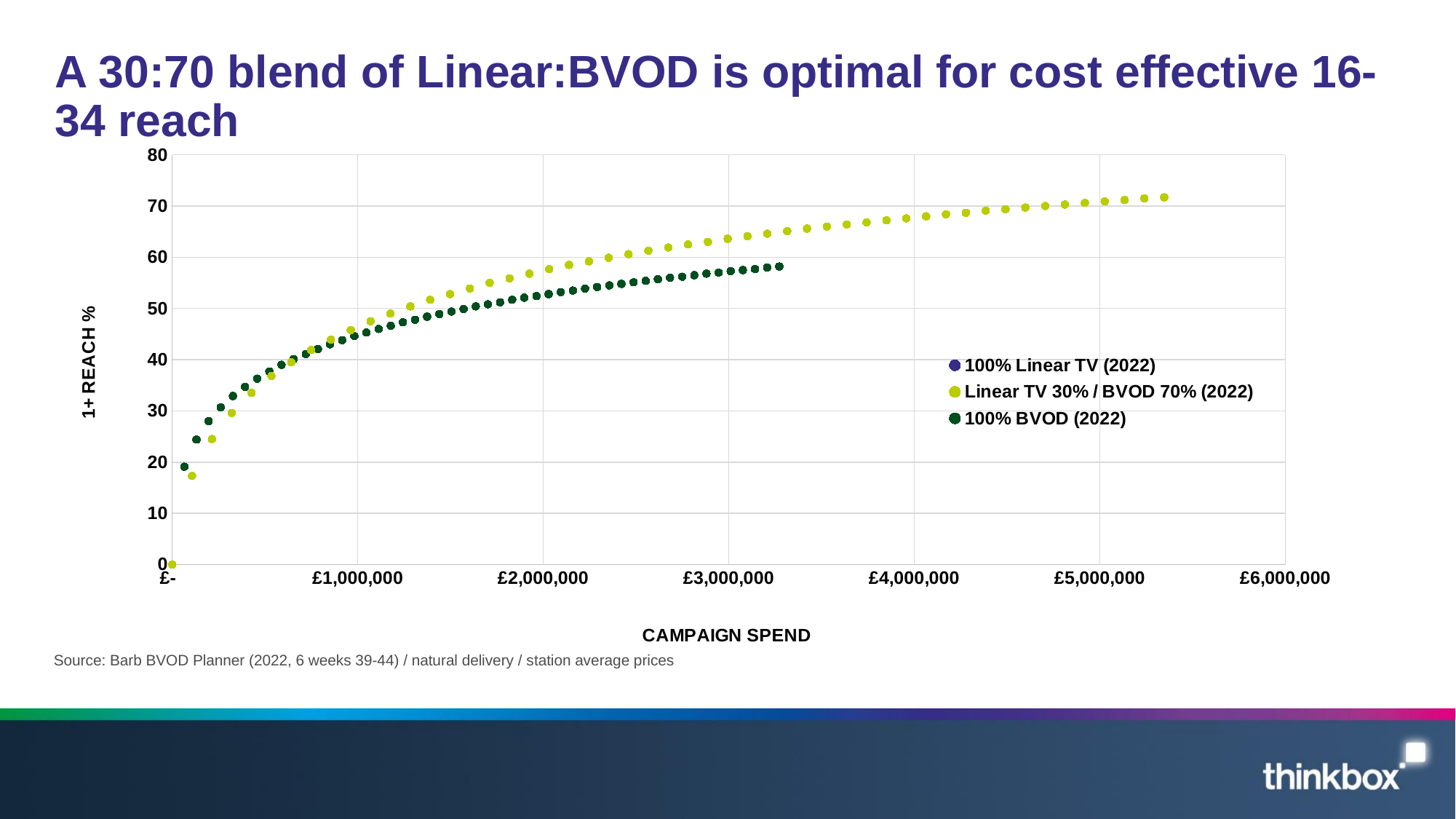
What is the title of the x axis? CAMPAIGN SPEND At a campaign spend of £3,000,000, which series has the higher 1+ reach %: Linear TV 30% / BVOD 70% (2022) or 100% BVOD (2022)? Linear TV 30% / BVOD 70% (2022) Does 1+ reach % rise or fall as campaign spend increases for the Linear TV 30% / BVOD 70% (2022) series? rise Which series extends to the highest campaign spend on the chart? Linear TV 30% / BVOD 70% (2022) How many series does the legend list? 3 Which series reaches the highest 1+ reach % on the chart? Linear TV 30% / BVOD 70% (2022) Is the 1+ reach % for 100% BVOD (2022) at £3,000,000 campaign spend greater or less than 60? less What kind of chart is shown on the slide? scatter chart What is the title of the y axis? 1+ REACH % Is the 1+ reach % for Linear TV 30% / BVOD 70% (2022) at £2,000,000 campaign spend greater or less than 50? greater Is the 1+ reach % for Linear TV 30% / BVOD 70% (2022) at £5,000,000 campaign spend greater or less than 60? greater